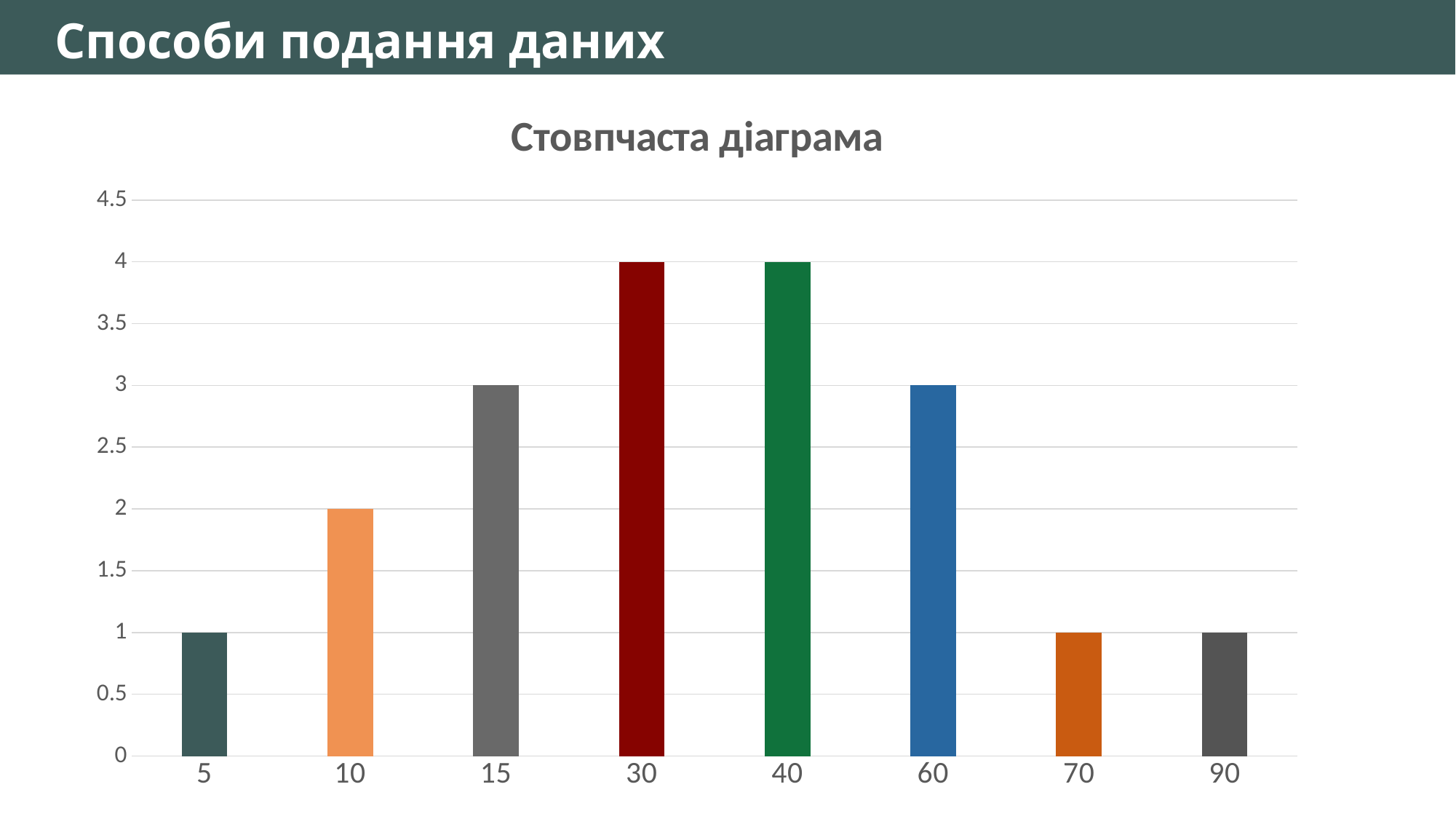
Is the value for category 30 greater or less than 3? greater What is the value for category 60? 3 Which has a larger value, category 15 or category 5? 15 How many bars (categories) are shown in the chart? 8 What is the value for category 10? 2 What is the title of the chart? Стовпчаста діаграма What is the value for category 30? 4 What type of chart is shown on the slide? bar chart What is the value for category 90? 1 What is the difference between the values for category 40 and category 70? 3 What is the value for category 15? 3 What is the difference between the values for category 60 and category 10? 1